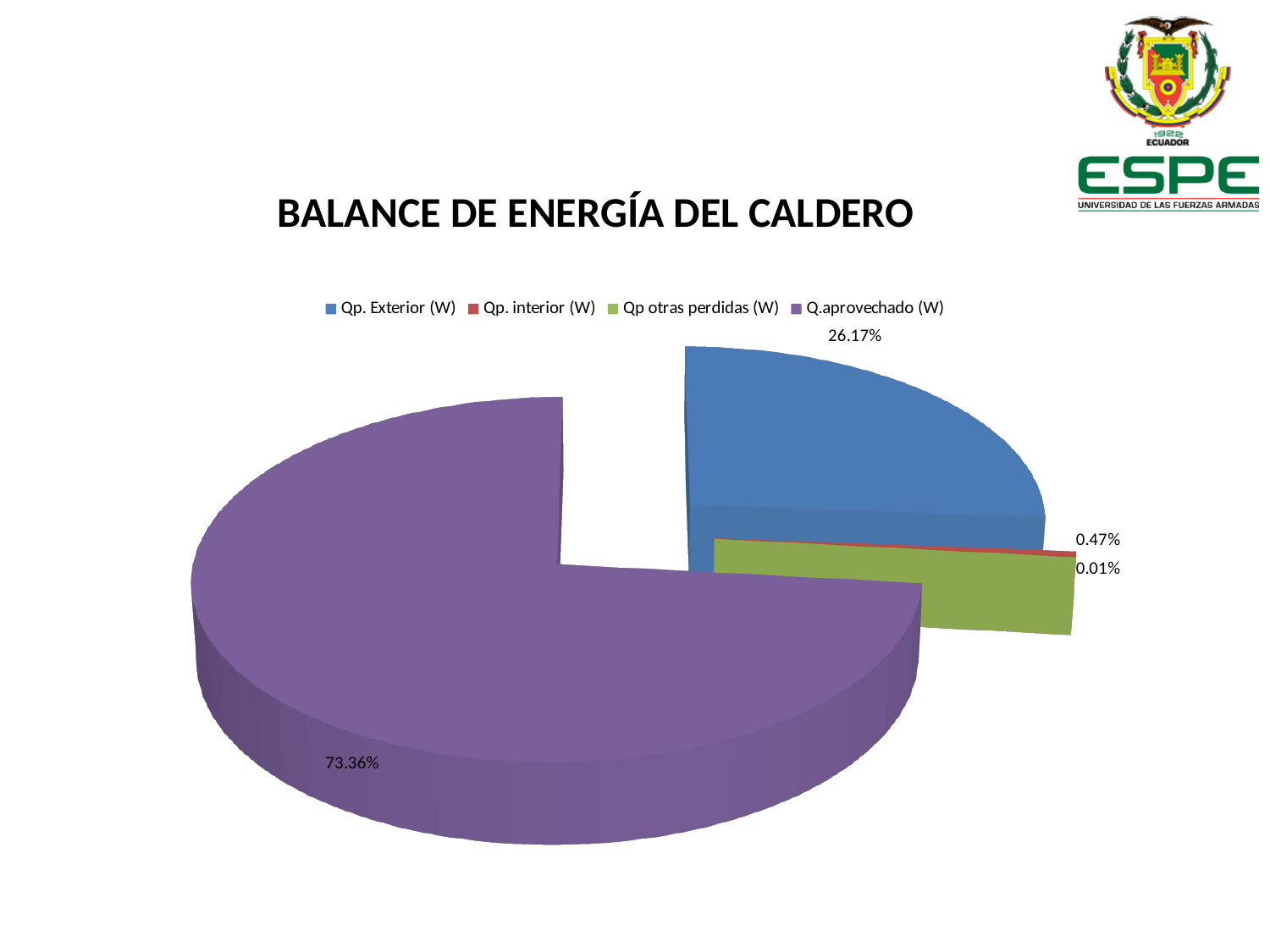
What colour is the slice for Q.aprovechado (W)? Purple What share of the pie does Qp. Exterior (W) represent? 26.17% What is the title of the chart? BALANCE DE ENERGÍA DEL CALDERO Which is larger, the share for Q.aprovechado (W) or the share for Qp. Exterior (W)? Q.aprovechado (W) Which category has the largest share of the pie? Q.aprovechado (W) How many slices does the pie chart have? 4 What share of the pie does Q.aprovechado (W) represent? 73.36% Is the share for Qp. Exterior (W) greater or less than 50%? less What type of chart is shown on the slide? Pie chart What is the difference between the share for Q.aprovechado (W) and the share for Qp. Exterior (W)? 47.19% How many entries does the chart legend list? 4 What is the smallest percentage shown on the chart? 0.01%